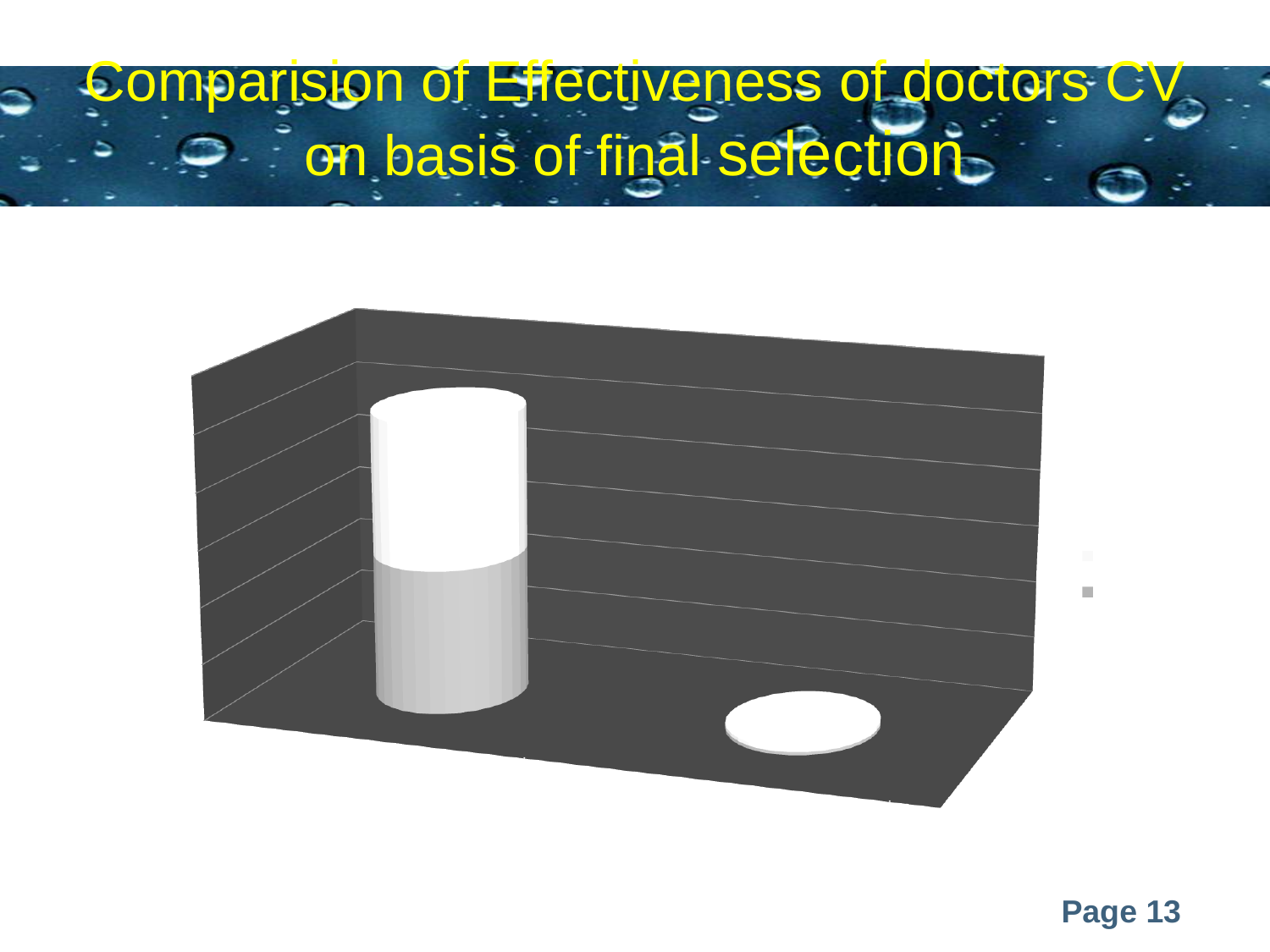
What kind of chart is shown on the slide? bar chart Is the chart drawn in 3D or 2D? 3D How many bars are plotted in the chart? 2 What is the title of the slide containing the chart? Comparision of Effectiveness of doctors CV on basis of final selection Which bar is taller, the one on the left or the one on the right? the one on the left